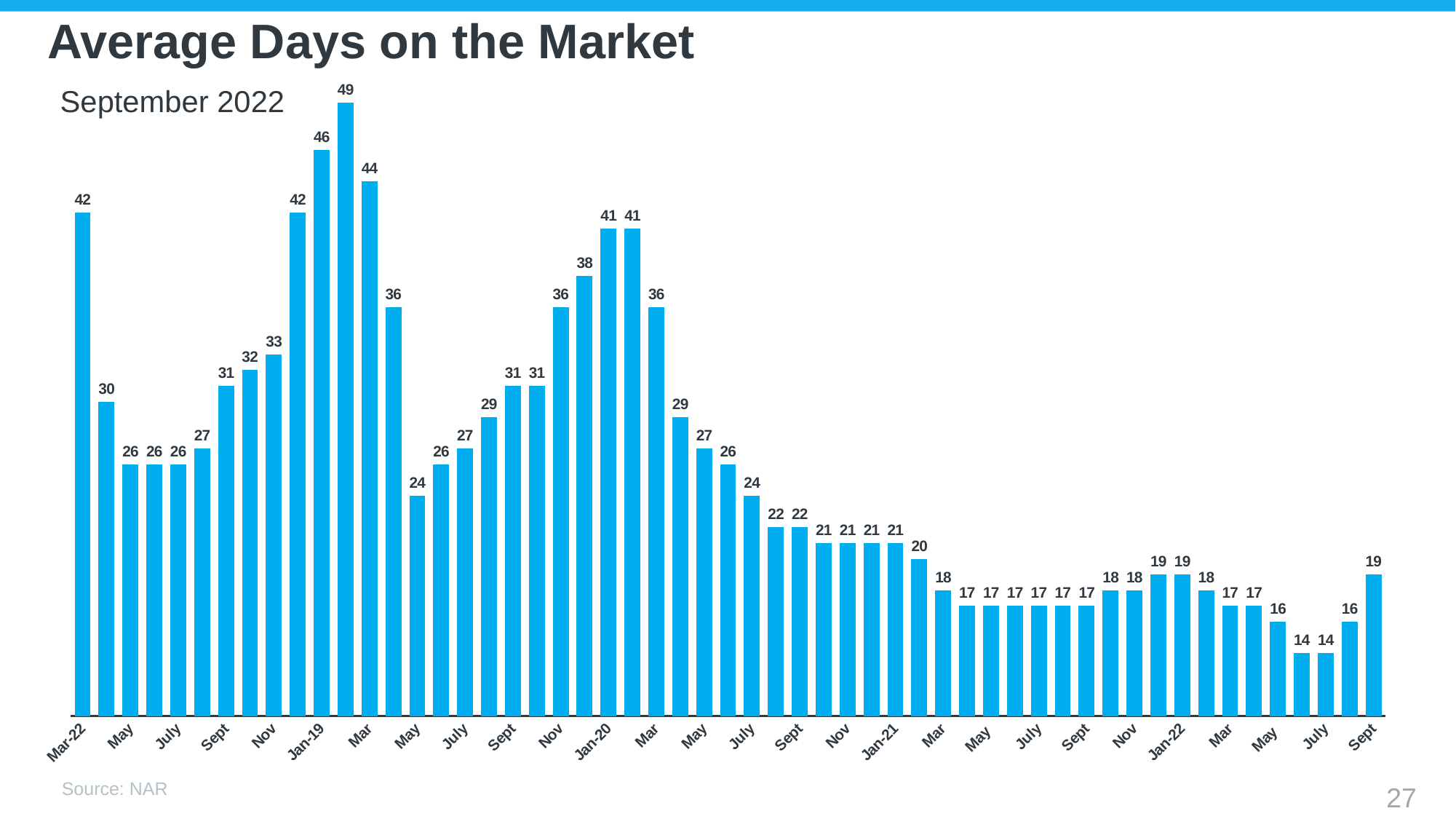
What is the difference between the values for Jan-19 and Jan-22? 27 Which has a higher value, Jan-20 or Jan-21? Jan-20 What is the average days on the market for Jan-20? 41 How many bars are plotted on the chart? 55 What is the lowest value shown on the chart? 14 What is the average days on the market for Jan-21? 21 What is the value of the first bar, labeled Mar-22? 42 What kind of chart is shown on the slide? bar chart What is the highest value shown on the chart? 49 What is the average days on the market for Jan-22? 19 What is the average days on the market for Jan-19? 46 What is the title of the chart? Average Days on the Market